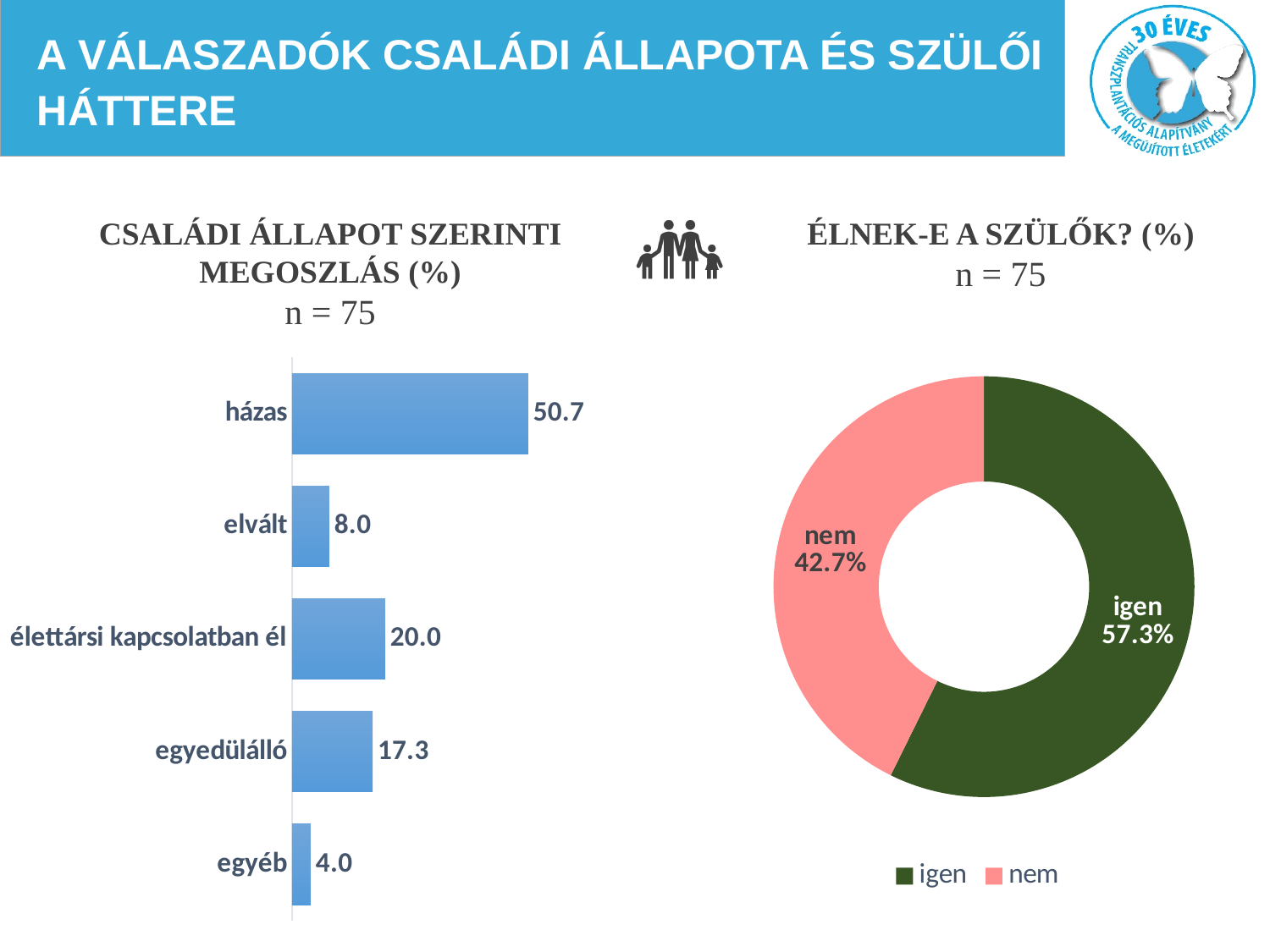
In the 'CSALÁDI ÁLLAPOT SZERINTI MEGOSZLÁS (%)' chart, which category has the lowest value? egyéb In the 'CSALÁDI ÁLLAPOT SZERINTI MEGOSZLÁS (%)' chart, what is the value for 'házas'? 50.7 In the 'CSALÁDI ÁLLAPOT SZERINTI MEGOSZLÁS (%)' chart, what is the difference between the values for 'házas' and 'egyedülálló'? 33.4 How many entries does the legend of the 'ÉLNEK-E A SZÜLŐK? (%)' chart list? 2 What kind of chart is the 'CSALÁDI ÁLLAPOT SZERINTI MEGOSZLÁS (%)' chart? bar chart In the 'CSALÁDI ÁLLAPOT SZERINTI MEGOSZLÁS (%)' chart, which category has the highest value? házas How many categories are shown in the 'CSALÁDI ÁLLAPOT SZERINTI MEGOSZLÁS (%)' chart? 5 In the 'CSALÁDI ÁLLAPOT SZERINTI MEGOSZLÁS (%)' chart, which is larger: 'elvált' or 'egyedülálló'? egyedülálló In the 'ÉLNEK-E A SZÜLŐK? (%)' chart, what is the share for 'nem'? 42.7% In the 'CSALÁDI ÁLLAPOT SZERINTI MEGOSZLÁS (%)' chart, what is the value for 'élettársi kapcsolatban él'? 20.0 What is the sample size (n) stated under the 'ÉLNEK-E A SZÜLŐK? (%)' chart title? n = 75 In the 'ÉLNEK-E A SZÜLŐK? (%)' chart, what is the share for 'igen'? 57.3%